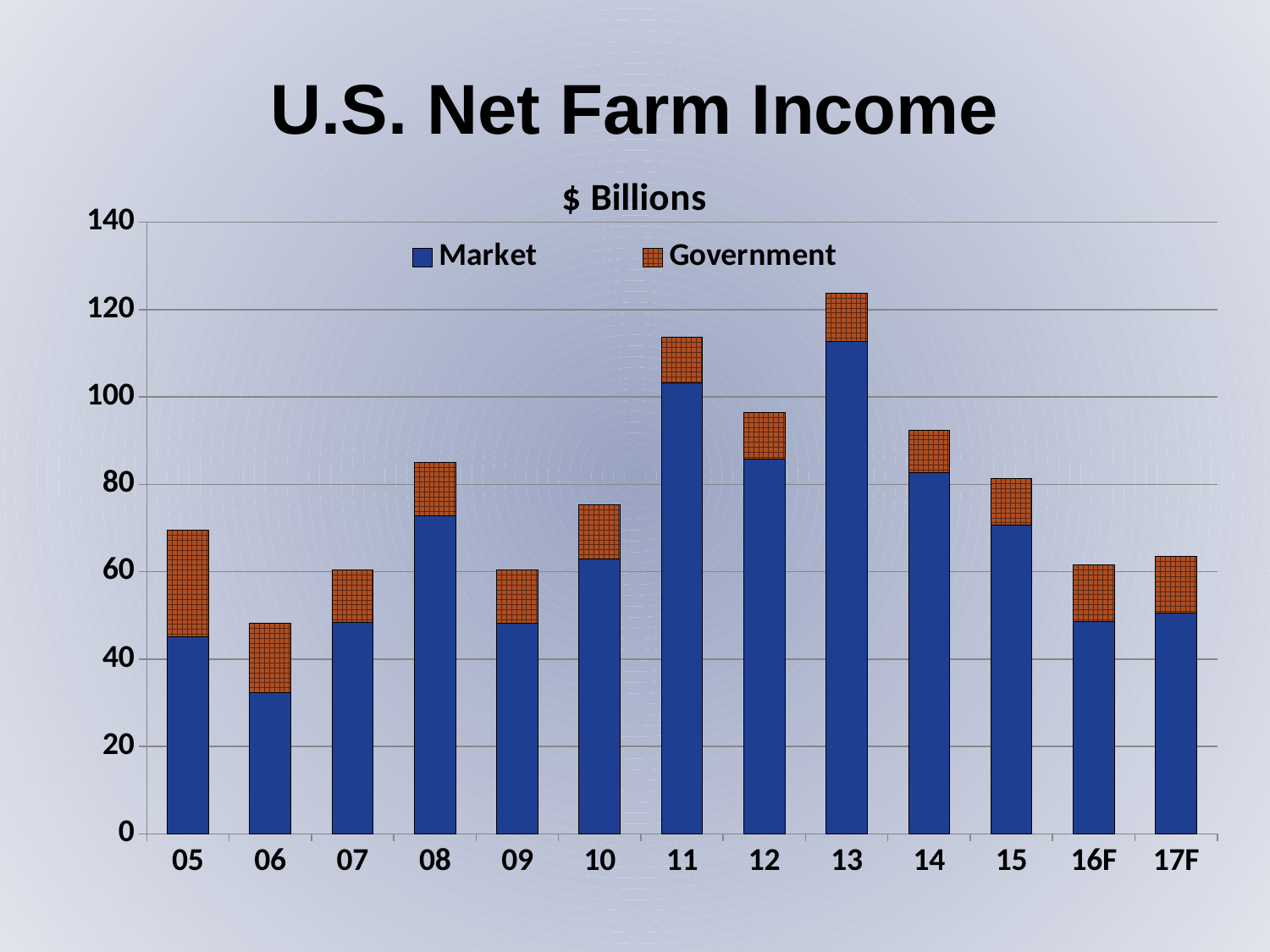
Which year has the highest total net farm income? 13 Is the total value for 11 greater or less than 100? greater Which year has the lowest total net farm income? 06 How many series does the legend list? 2 Do the total values rise or fall from 13 to 16F? fall What kind of chart is shown on the slide? Stacked bar chart Is the total value for 10 greater or less than 80? less What are the two series named in the legend? Market and Government Is the total value for 06 greater or less than 60? less How many years (categories) are shown on the x axis? 13 Which year has the larger total net farm income, 11 or 12? 11